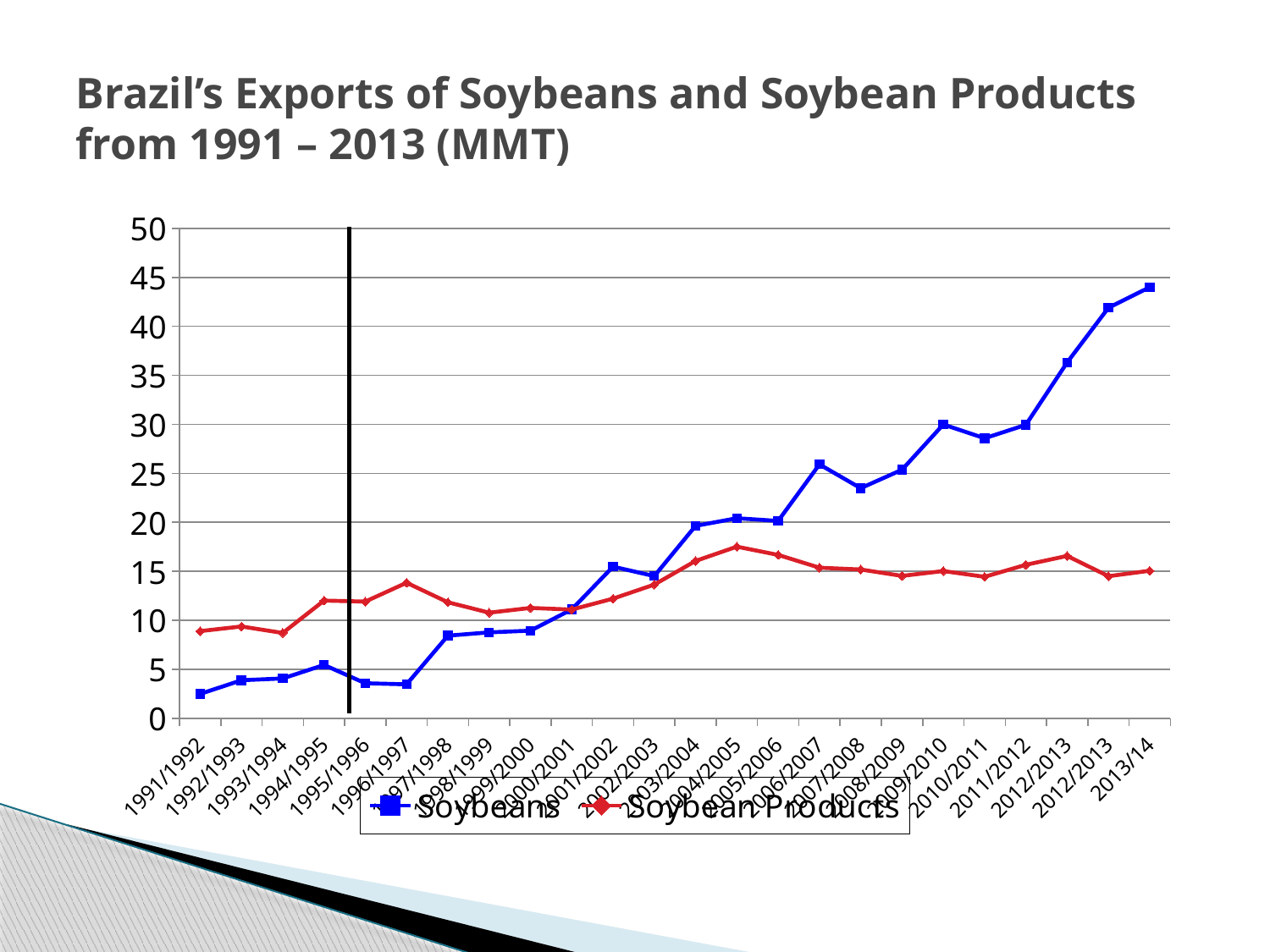
Is the value for Soybean Products in 1991/1992 greater or less than 5? greater In which period does the Soybeans series reach its highest value? 2013/14 Is the value for Soybeans in 1991/1992 greater or less than 5? less Do the Soybeans values overall rise or fall from 1991/1992 to 2013/14? rise Which two series are listed in the legend? Soybeans and Soybean Products How many series does the legend list? 2 Is the value for Soybean Products in 2013/14 greater or less than 20? less What colour is the Soybeans line? blue In 2013/14, which series has the larger value, Soybeans or Soybean Products? Soybeans What kind of chart is shown on the slide? line chart In 1991/1992, which series has the larger value, Soybeans or Soybean Products? Soybean Products